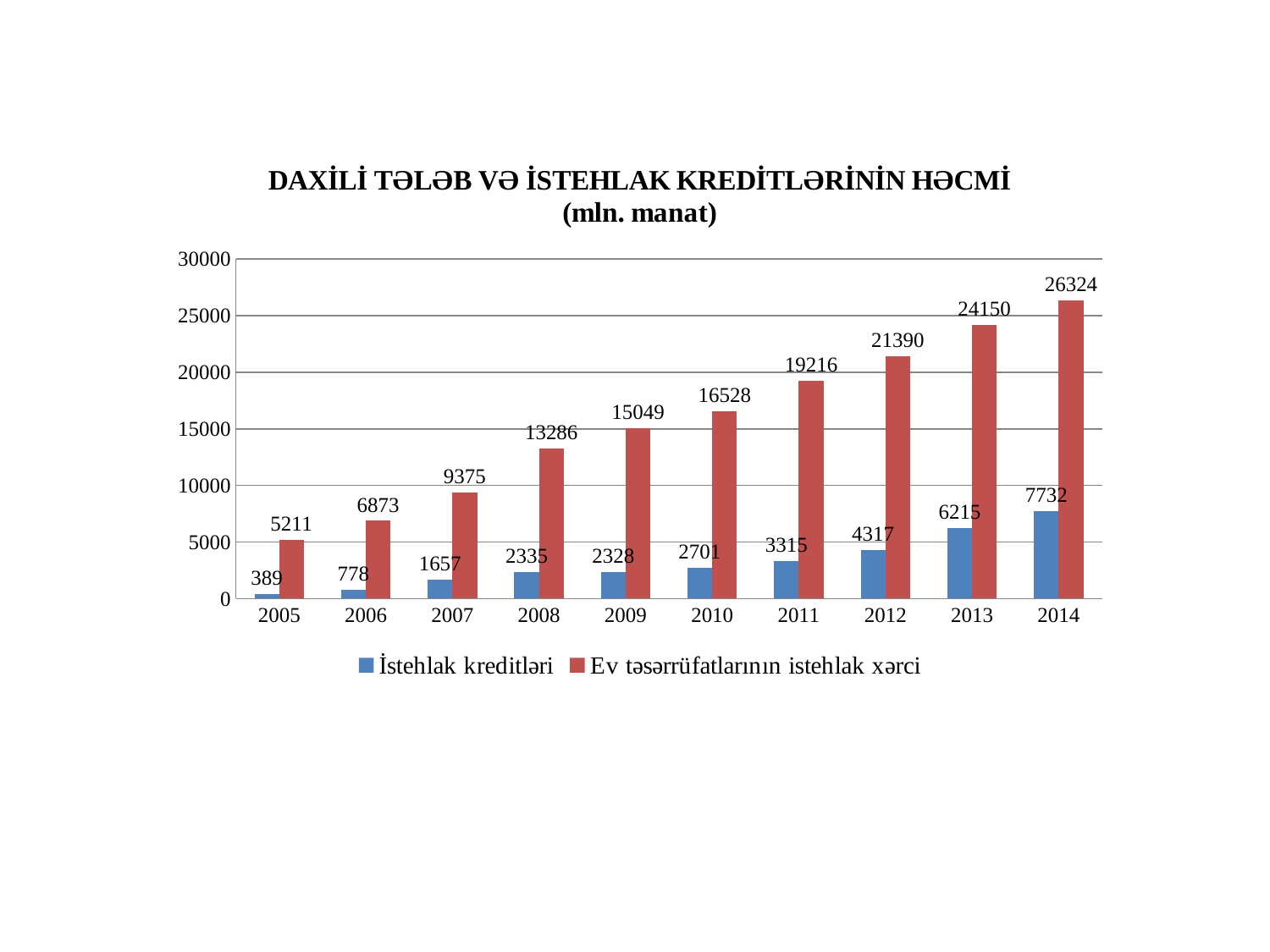
Which year has the highest value for Ev təsərrüfatlarının istehlak xərci? 2014 Which year has the lowest value for İstehlak kreditləri? 2005 What is the difference between İstehlak kreditləri in 2013 and in 2012? 1898 What kind of chart is shown on the slide? bar chart Is the value of Ev təsərrüfatlarının istehlak xərci for 2011 greater or less than 20000? less What is the value of Ev təsərrüfatlarının istehlak xərci for 2008? 13286 What is the value of İstehlak kreditləri for 2005? 389 What is the value of İstehlak kreditləri for 2010? 2701 Which is larger, İstehlak kreditləri in 2008 or in 2009? 2008 What is the difference between Ev təsərrüfatlarının istehlak xərci in 2014 and in 2013? 2174 How many series does the legend list? 2 How many years are shown on the x axis? 10